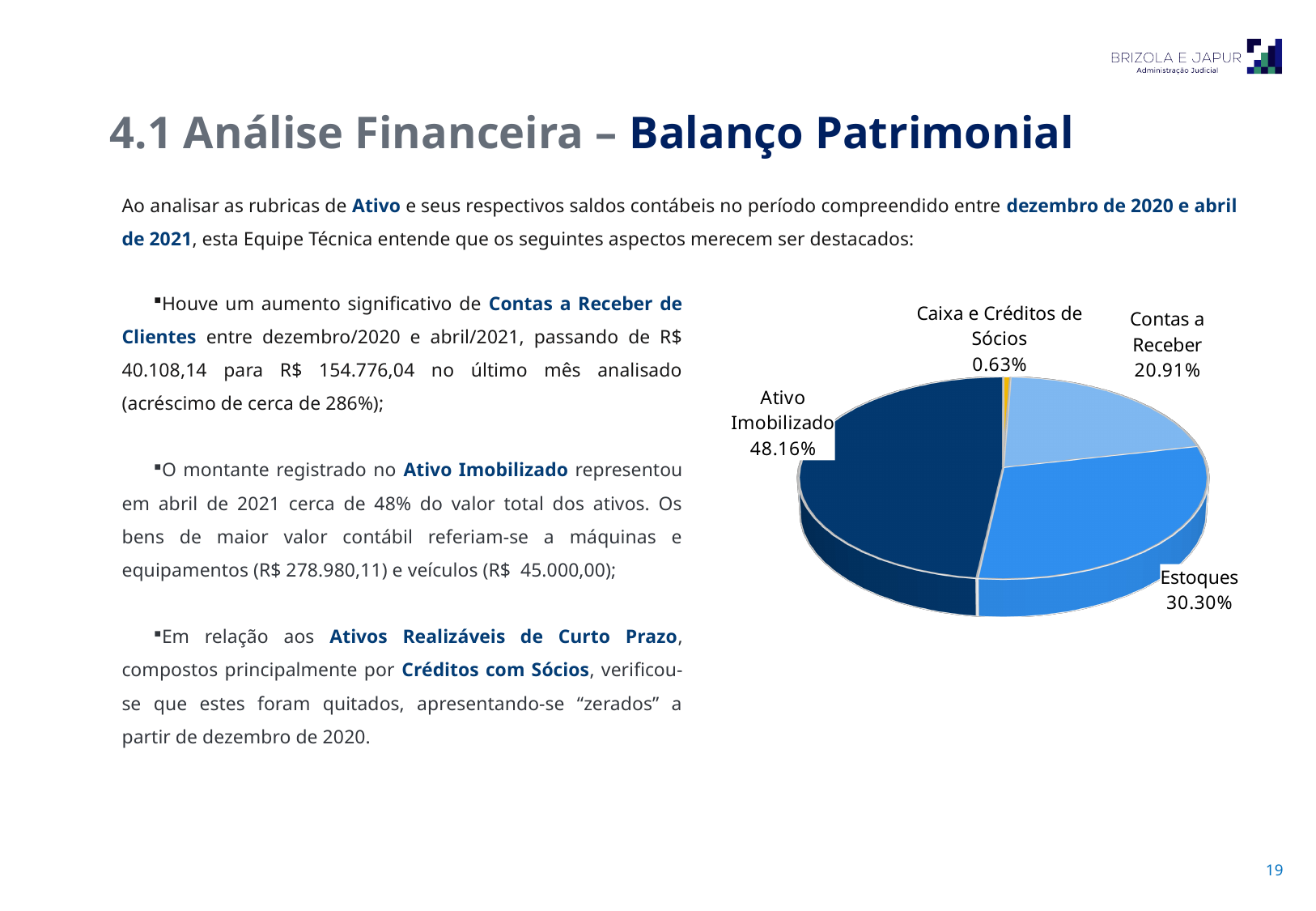
What share of the pie does Ativo Imobilizado represent? 48.16% What is the difference in percentage points between Estoques and Contas a Receber? 9.39 Which slice of the pie chart is the smallest? Caixa e Créditos de Sócios Which slice of the pie chart is the largest? Ativo Imobilizado What share of the pie does Contas a Receber represent? 20.91% Which is larger, Estoques or Contas a Receber? Estoques Which slice of the pie chart is coloured dark navy blue? Ativo Imobilizado What share of the pie does Estoques represent? 30.30% How many slices does the pie chart have? 4 What share of the pie does Caixa e Créditos de Sócios represent? 0.63% What kind of chart is shown on the slide? Pie chart What is the difference in percentage points between Ativo Imobilizado and Estoques? 17.86